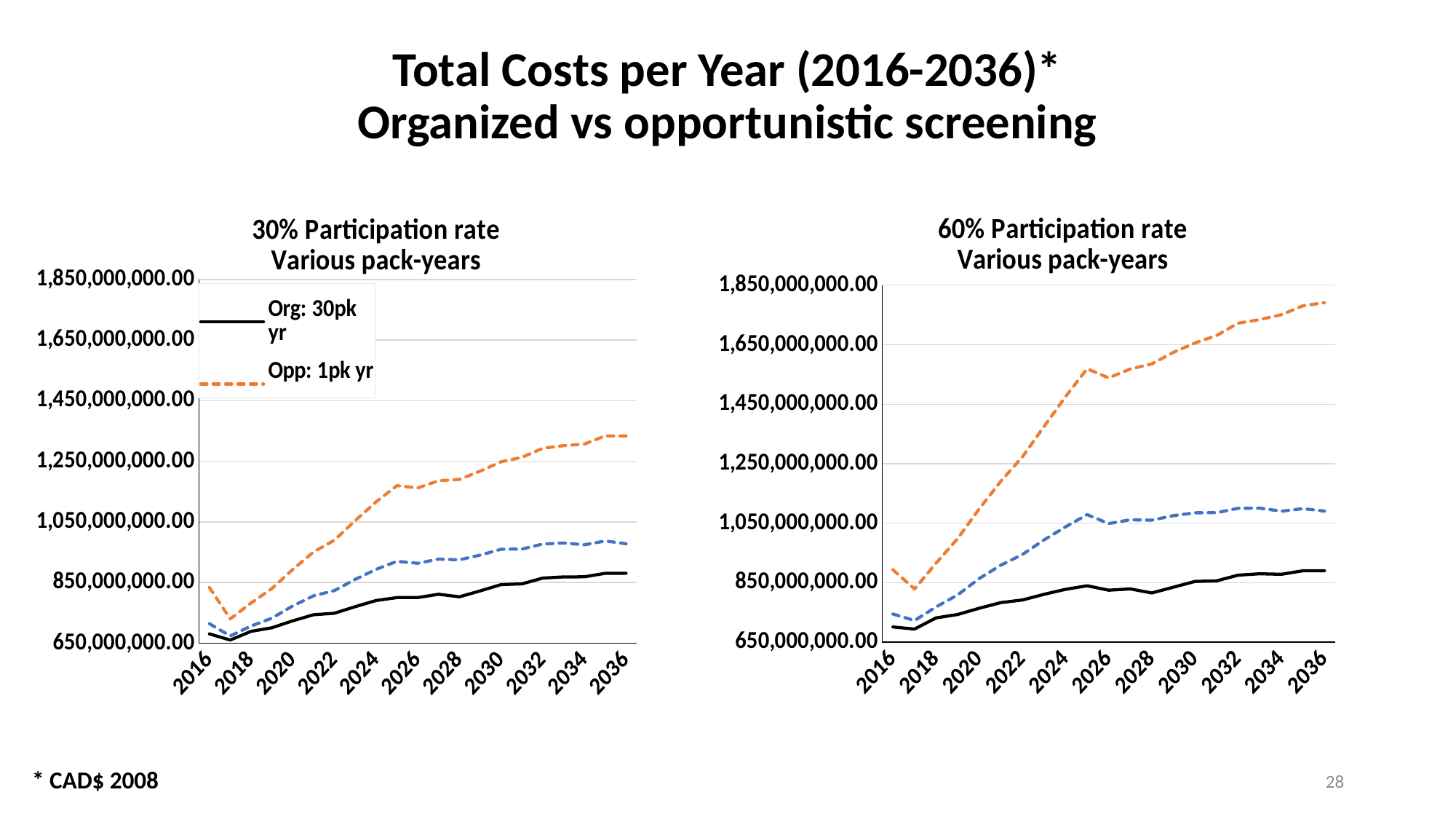
In the '60% Participation rate' chart, is the value for 'Opp: 1pk yr' in 2036 greater or less than 1,650,000,000.00? greater In the '30% Participation rate' chart, is the value for 'Org: 30pk yr' in 2016 greater or less than 850,000,000.00? less What kind of chart is the '30% Participation rate' chart on the left? Line chart In the '30% Participation rate' chart, which series has the lowest value in 2036? Org: 30pk yr In the '60% Participation rate' chart, which series has the highest value in 2036? Opp: 1pk yr Does the 'Org: 30pk yr' line in the '60% Participation rate' chart generally rise or fall from 2016 to 2036? Rise What currency note is given in the footnote at the bottom of the slide? * CAD$ 2008 In the '60% Participation rate' chart, which is larger in 2036: 'Opp: 1pk yr' or 'Org: 30pk yr'? Opp: 1pk yr How many year labels are shown on the x axis of the '30% Participation rate' chart? 11 What is the highest value shown on the y axis of the '60% Participation rate' chart? 1,850,000,000.00 In the '30% Participation rate' chart, is the value for 'Opp: 1pk yr' in 2036 greater or less than 1,250,000,000.00? greater